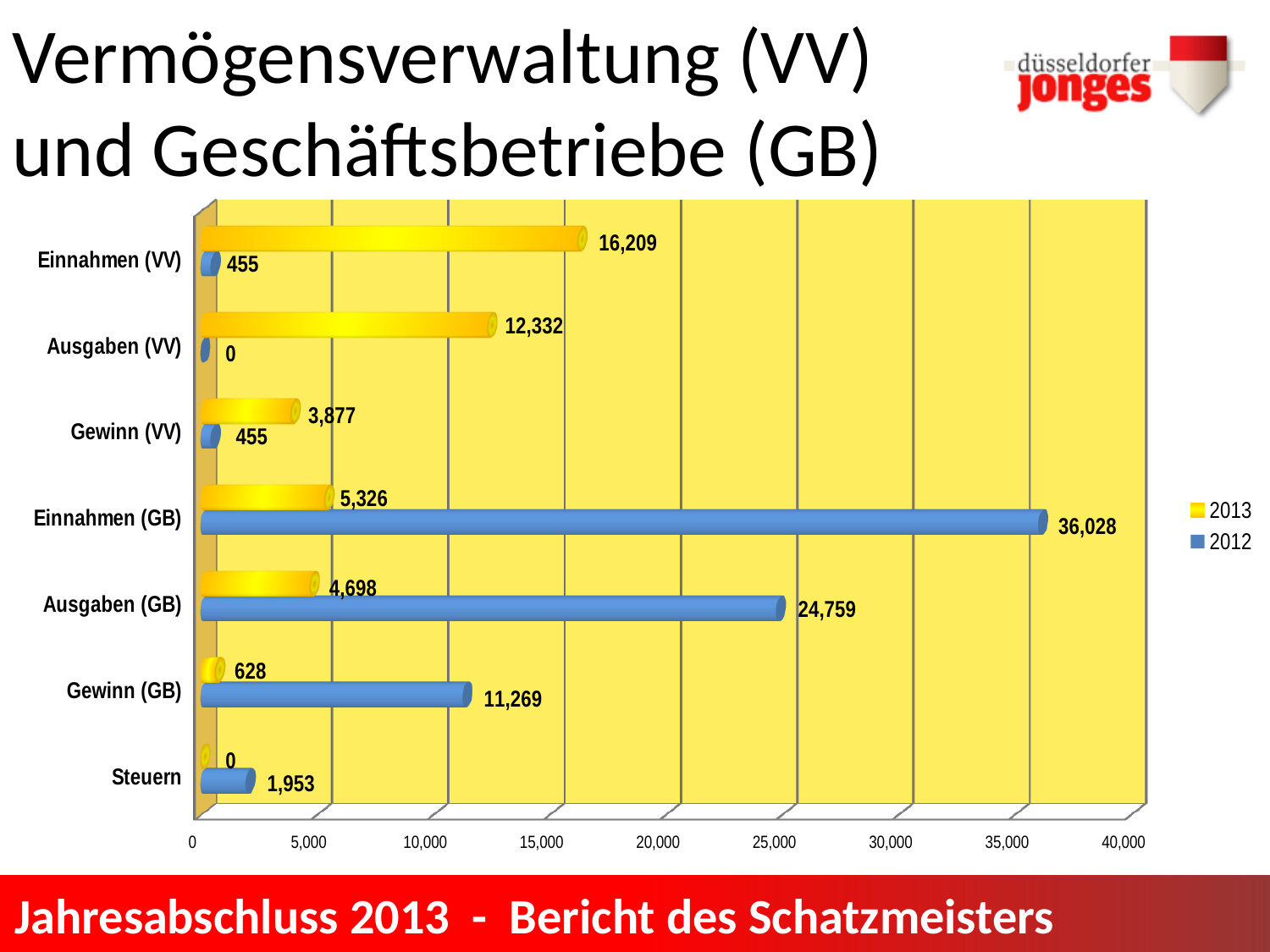
How many series does the legend list? 2 What kind of chart is shown on the slide? Bar chart What is the difference between the 2013 values for Einnahmen (VV) and Ausgaben (VV)? 3,877 How many categories are shown on the chart? 7 Which category has the highest 2012 value? Einnahmen (GB) What is the 2013 value for Einnahmen (VV)? 16,209 What is the 2012 value for Steuern? 1,953 Which category has the highest 2013 value? Einnahmen (VV) What is the 2013 value for Ausgaben (GB)? 4,698 What is the 2012 value for Einnahmen (GB)? 36,028 What is the difference between the 2012 and 2013 values for Einnahmen (GB)? 30,702 Which is larger for Gewinn (GB): the 2012 value or the 2013 value? 2012